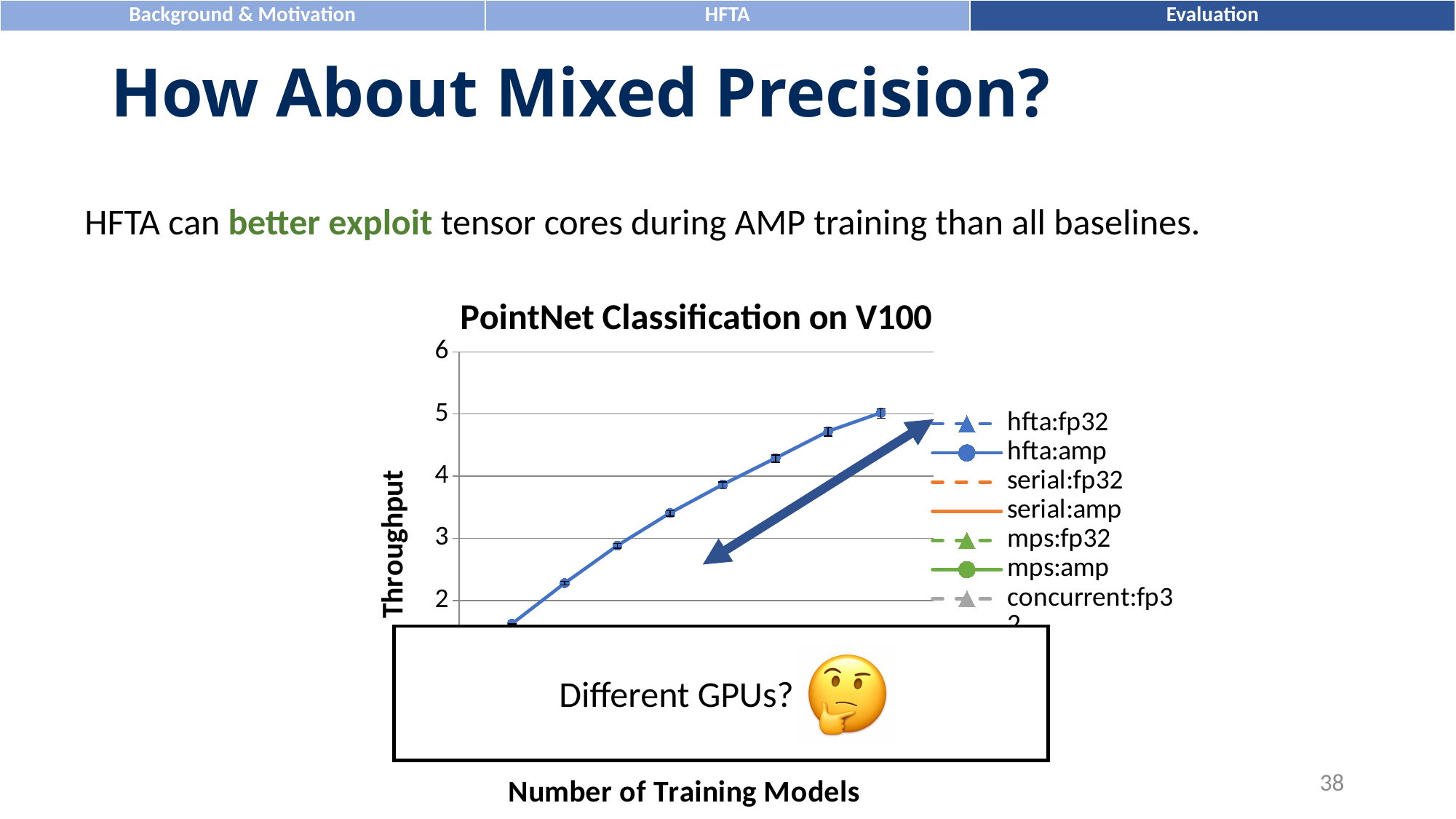
Is the throughput of the highest plotted point on the chart greater or less than 6? less What is the highest value shown on the y axis of the chart? 6 What is the label of the y axis of the chart? Throughput What is the title of the chart? PointNet Classification on V100 Is the throughput of the rightmost plotted point of the hfta:amp line greater or less than 4? greater Which legend entry corresponds to the solid blue line with circle markers? hfta:amp Is the throughput of the leftmost visible plotted point of the hfta:amp line greater or less than 3? less Does the plotted hfta:amp line rise or fall as the number of training models increases? rises What kind of chart is shown on the slide? line chart